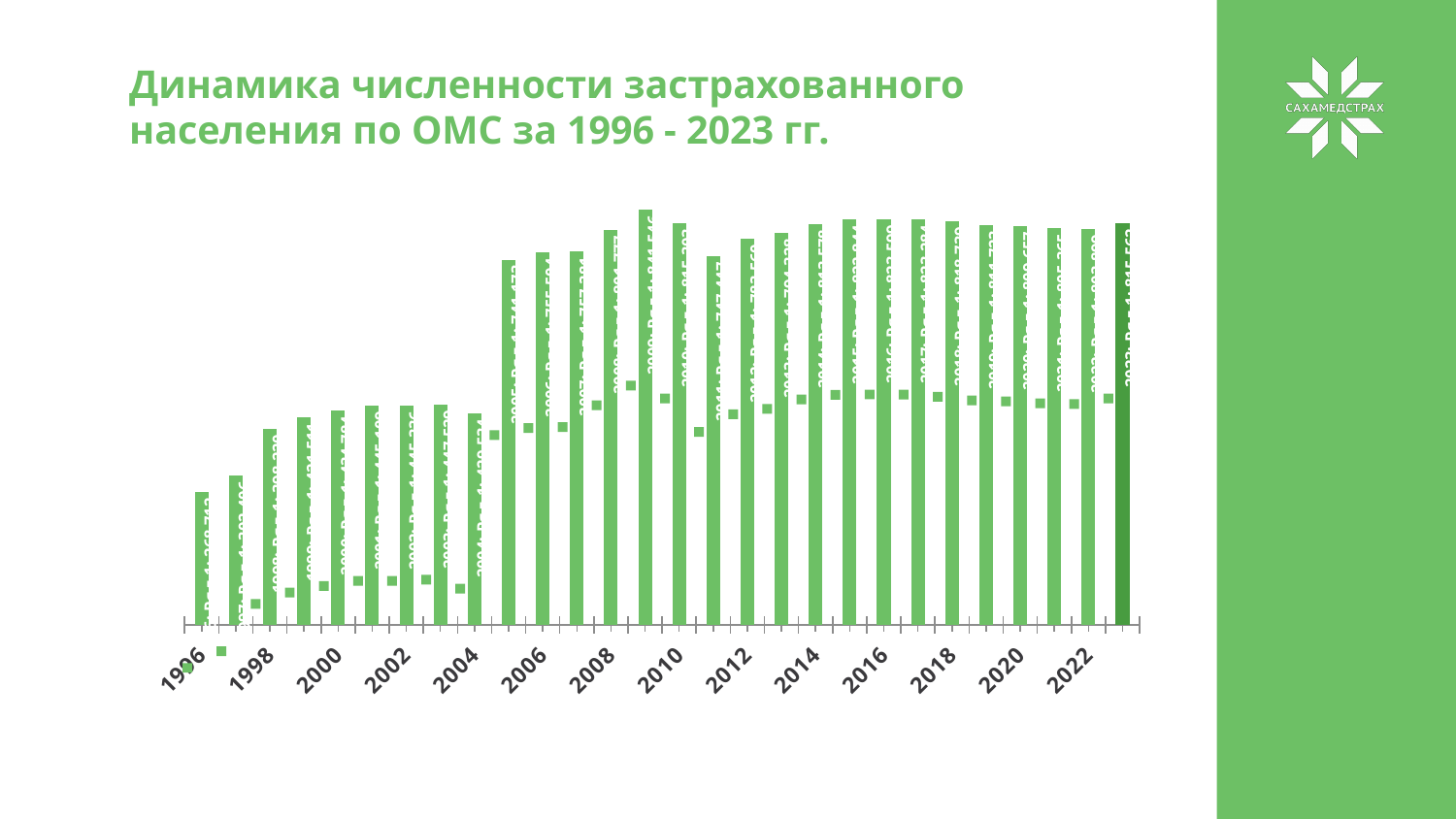
Which year has the larger value, 2008 or 2009? 2009 What kind of chart is shown on the slide? Bar chart Which year has the larger value, 2010 or 2011? 2010 What is the title of the slide? Динамика численности застрахованного населения по ОМС за 1996 - 2023 гг. Which year has the larger value, 2004 or 2005? 2005 Which year's bar is drawn in a darker shade of green than the others? 2023 Which year has the highest number of insured population in the chart? 2009 Do the values generally rise or fall from 1996 to 2009? Rise Which year has the lowest number of insured population in the chart? 1996 Do the values rise or fall from 2009 to 2011? Fall How many years (bars) are plotted in the chart? 28